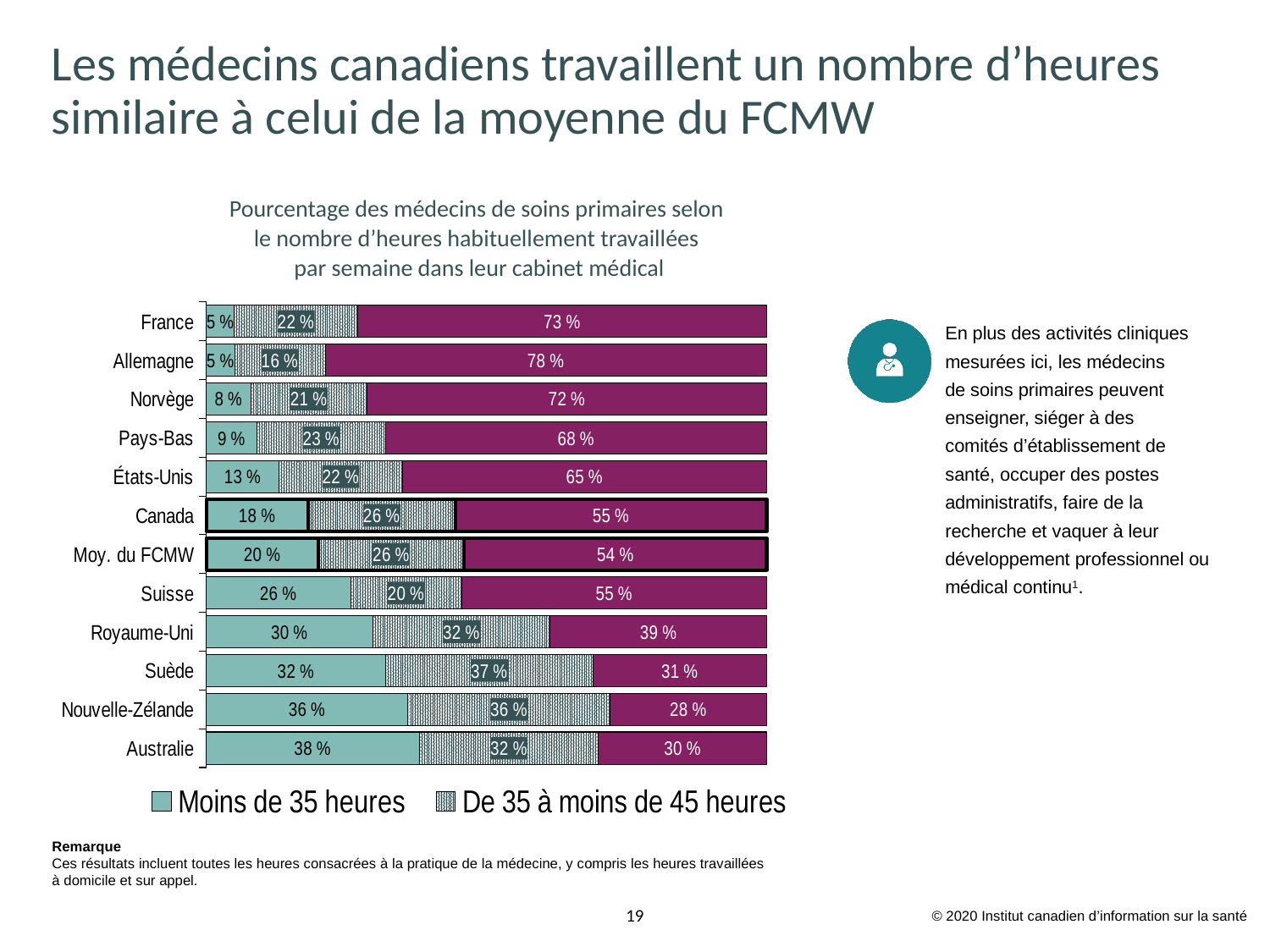
How many series does the chart's legend list? 2 What percentage of primary care physicians in Canada work "Moins de 35 heures" per week? 18 % What is the value for Royaume-Uni in the "De 35 à moins de 45 heures" series? 32 % Which has a larger "De 35 à moins de 45 heures" value, Suède or Royaume-Uni? Suède What is the difference between the "Moins de 35 heures" values for Moy. du FCMW and Canada? 2 percentage points How many categories (countries/averages) are shown on the chart? 12 Which country has the lowest value in the purple (rightmost) segment? Nouvelle-Zélande What is the value of the purple (rightmost) segment for Allemagne? 78 % What is the total of the three printed values for the Canada bar? 99 % What kind of chart is shown on the slide? Stacked bar chart Which category has the highest value for "De 35 à moins de 45 heures"? Suède Which country has the highest value for "Moins de 35 heures"? Australie